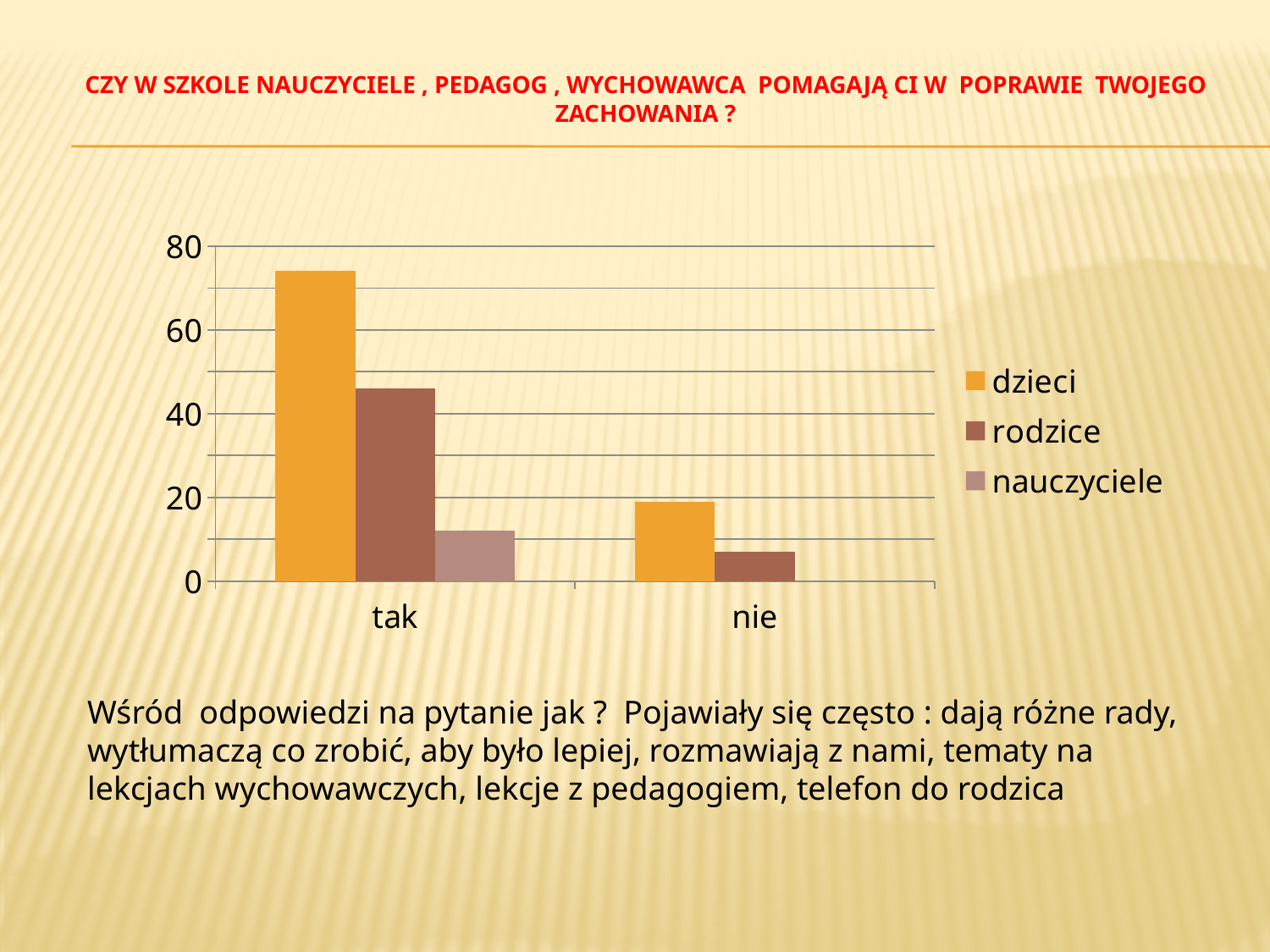
Which category has the lowest value for the rodzice series? nie Is the value for dzieci in the category tak greater or less than 60? greater For the category tak, which is larger: dzieci or rodzice? dzieci Is the value for rodzice in the category tak greater or less than 60? less For the category nie, which is larger: dzieci or rodzice? dzieci What are the series listed in the legend? dzieci, rodzice, nauczyciele Which category has the highest value for the dzieci series? tak How many series does the legend list? 3 Is the value for nauczyciele in the category tak greater or less than 20? less Do the values for the dzieci series rise or fall from tak to nie? fall What kind of chart is shown on the slide? bar chart How many categories are shown on the x axis? 2